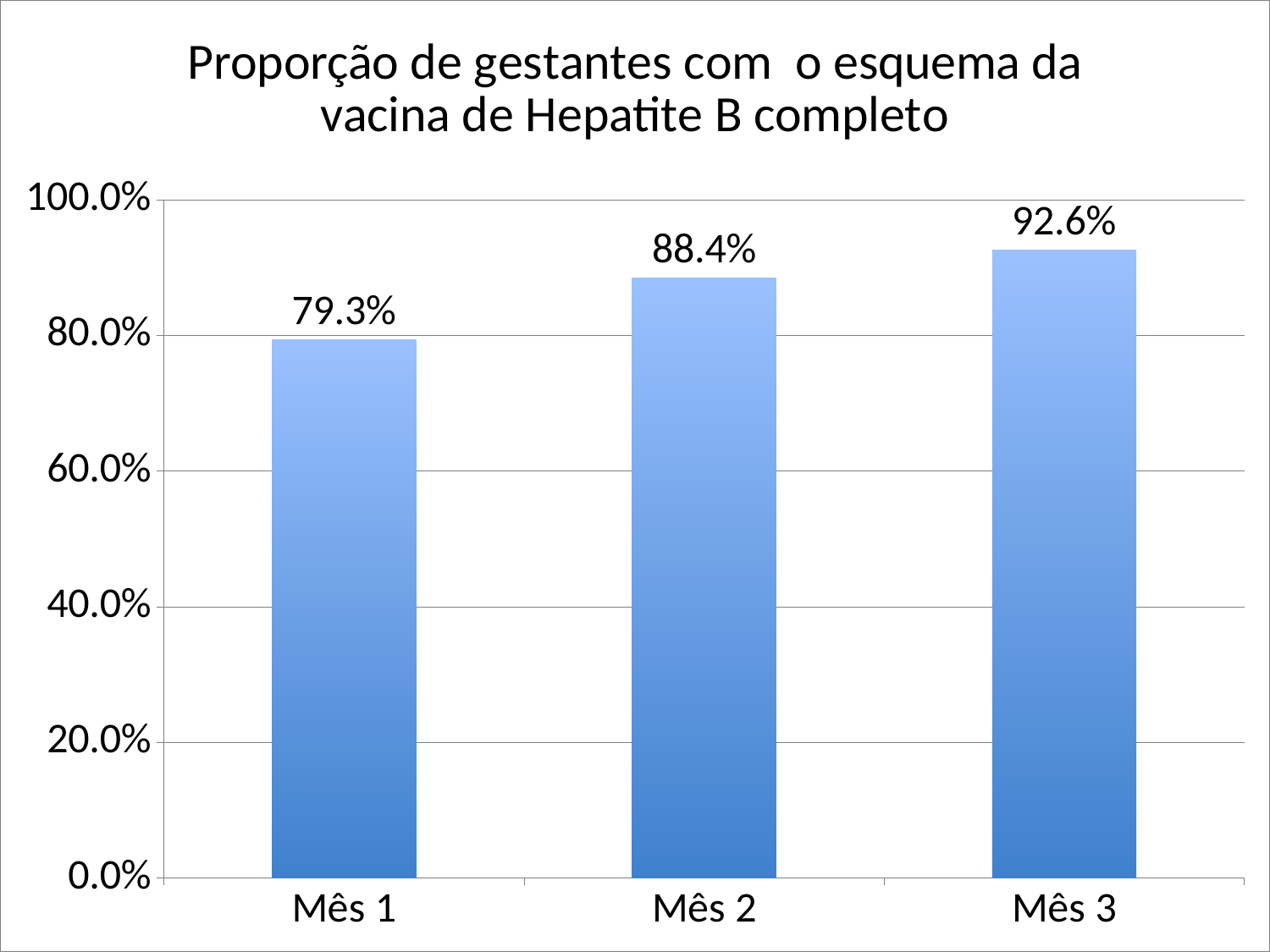
Which is larger, the value for Mês 2 or the value for Mês 3? Mês 3 What is the difference between the values for Mês 3 and Mês 1? 13.3% Which month has the lowest proportion? Mês 1 What is the difference between the values for Mês 2 and Mês 1? 9.1% Is the value for Mês 1 greater or less than 80.0%? less What is the value for Mês 1? 79.3% Do the values rise or fall from Mês 1 to Mês 3? rise How many categories are shown on the x axis? 3 What is the value for Mês 2? 88.4% Which month has the highest proportion? Mês 3 What kind of chart is this? bar chart What is the value for Mês 3? 92.6%